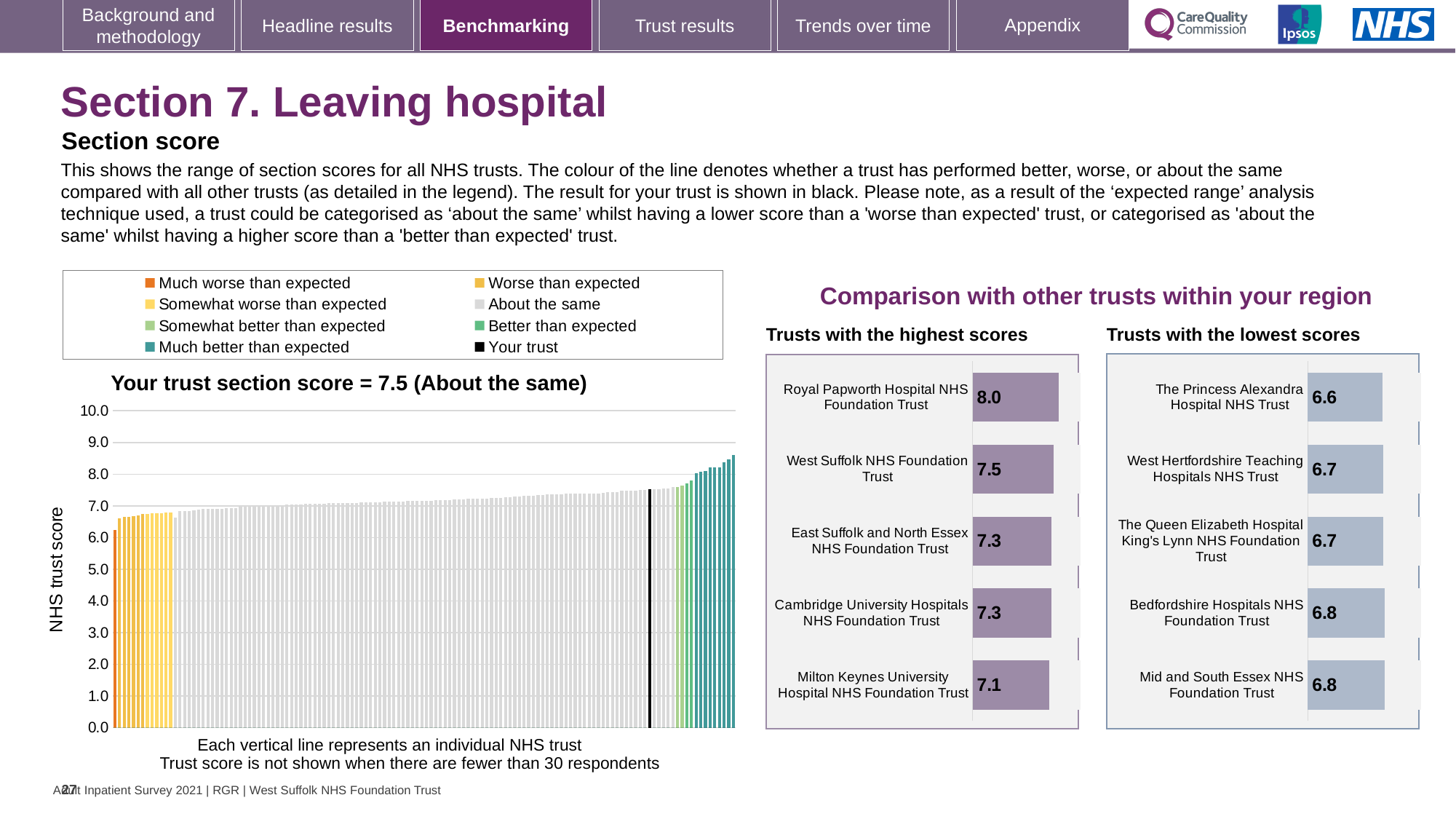
In the 'Trusts with the highest scores' chart, which trust has the highest score? Royal Papworth Hospital NHS Foundation Trust In the 'Trusts with the lowest scores' chart, what is the score for Bedfordshire Hospitals NHS Foundation Trust? 6.8 How many entries does the legend of the main chart on the left list? 8 In the 'Trusts with the highest scores' chart, which has the higher score: West Suffolk NHS Foundation Trust or Milton Keynes University Hospital NHS Foundation Trust? West Suffolk NHS Foundation Trust In the 'Trusts with the highest scores' chart, what is the score for Milton Keynes University Hospital NHS Foundation Trust? 7.1 In the 'Trusts with the highest scores' chart, what is the score for Royal Papworth Hospital NHS Foundation Trust? 8.0 In the 'Trusts with the lowest scores' chart, which trust has the lowest score? The Princess Alexandra Hospital NHS Trust How many trusts are shown in the 'Trusts with the lowest scores' chart? 5 In the 'Trusts with the lowest scores' chart, what is the score for The Princess Alexandra Hospital NHS Trust? 6.6 In the main chart on the left, what is the section score for your trust? 7.5 In the 'Trusts with the highest scores' chart, what is the difference between the scores of Royal Papworth Hospital NHS Foundation Trust and West Suffolk NHS Foundation Trust? 0.5 What type of chart is the 'Trusts with the highest scores' chart? Bar chart